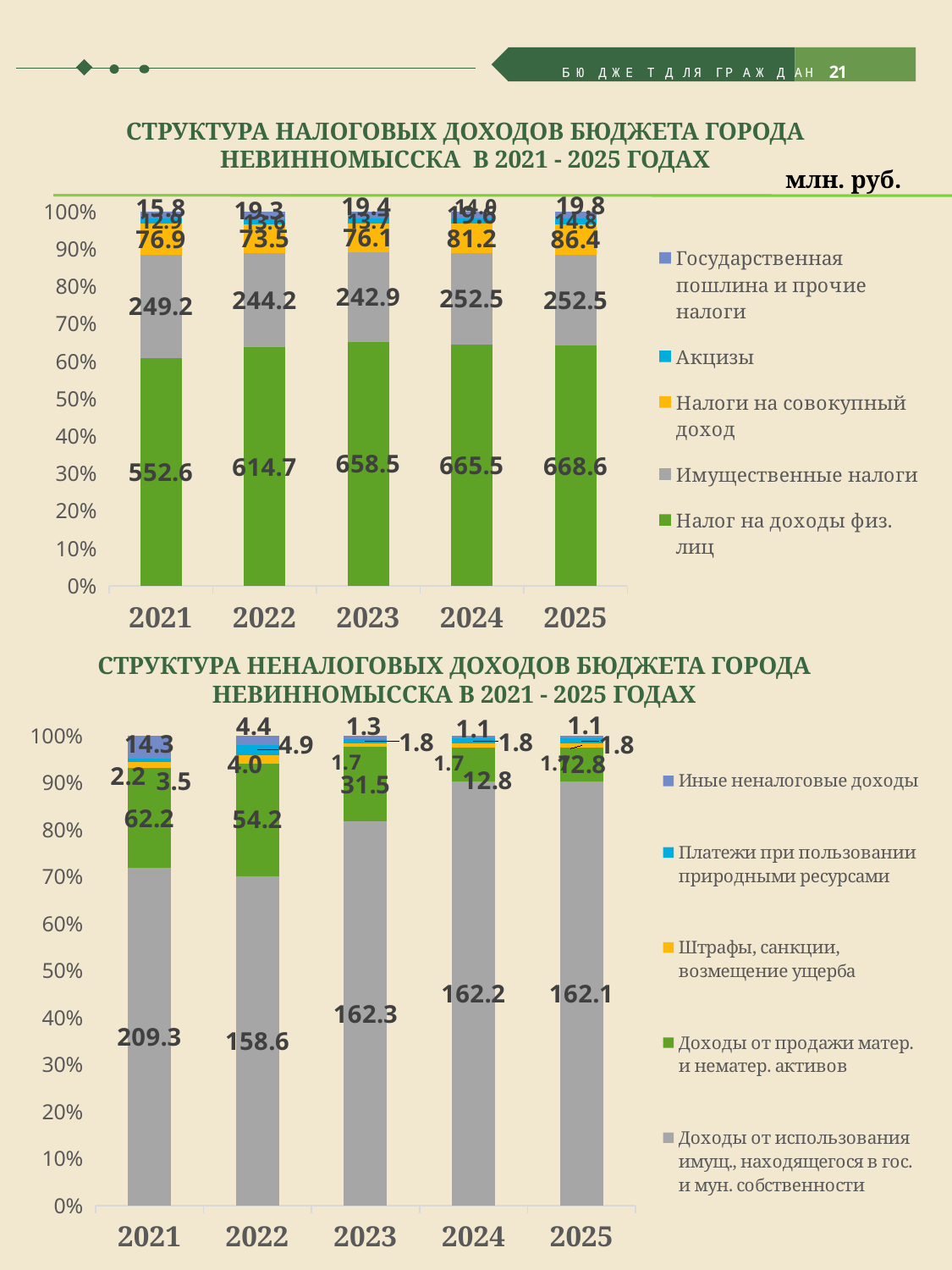
In the top chart (tax revenues), what is the value for 'Имущественные налоги' in 2021? 249.2 In the top chart (tax revenues), does 'Налог на доходы физ. лиц' rise or fall from 2021 to 2025? rise In the bottom chart (non-tax revenues), what is the value for 'Доходы от продажи матер. и нематер. активов' in 2023? 31.5 In the top chart (tax revenues), what is the value for 'Налог на доходы физ. лиц' in 2023? 658.5 What type of chart is the bottom chart (non-tax revenues)? stacked bar chart In the bottom chart (non-tax revenues), what is the value for 'Доходы от использования имущ., находящегося в гос. и мун. собственности' in 2021? 209.3 In the top chart (tax revenues), what is the value for 'Налоги на совокупный доход' in 2025? 86.4 In the top chart (tax revenues), in which year is 'Налог на доходы физ. лиц' the lowest? 2021 In the top chart (tax revenues), what is the difference between 'Налог на доходы физ. лиц' in 2025 and in 2021? 116.0 In the bottom chart (non-tax revenues), which is larger: 'Доходы от продажи матер. и нематер. активов' in 2021 or in 2022? 2021 In the top chart (tax revenues), how many series does the legend list? 5 In the bottom chart (non-tax revenues), how many years are shown on the x axis? 5